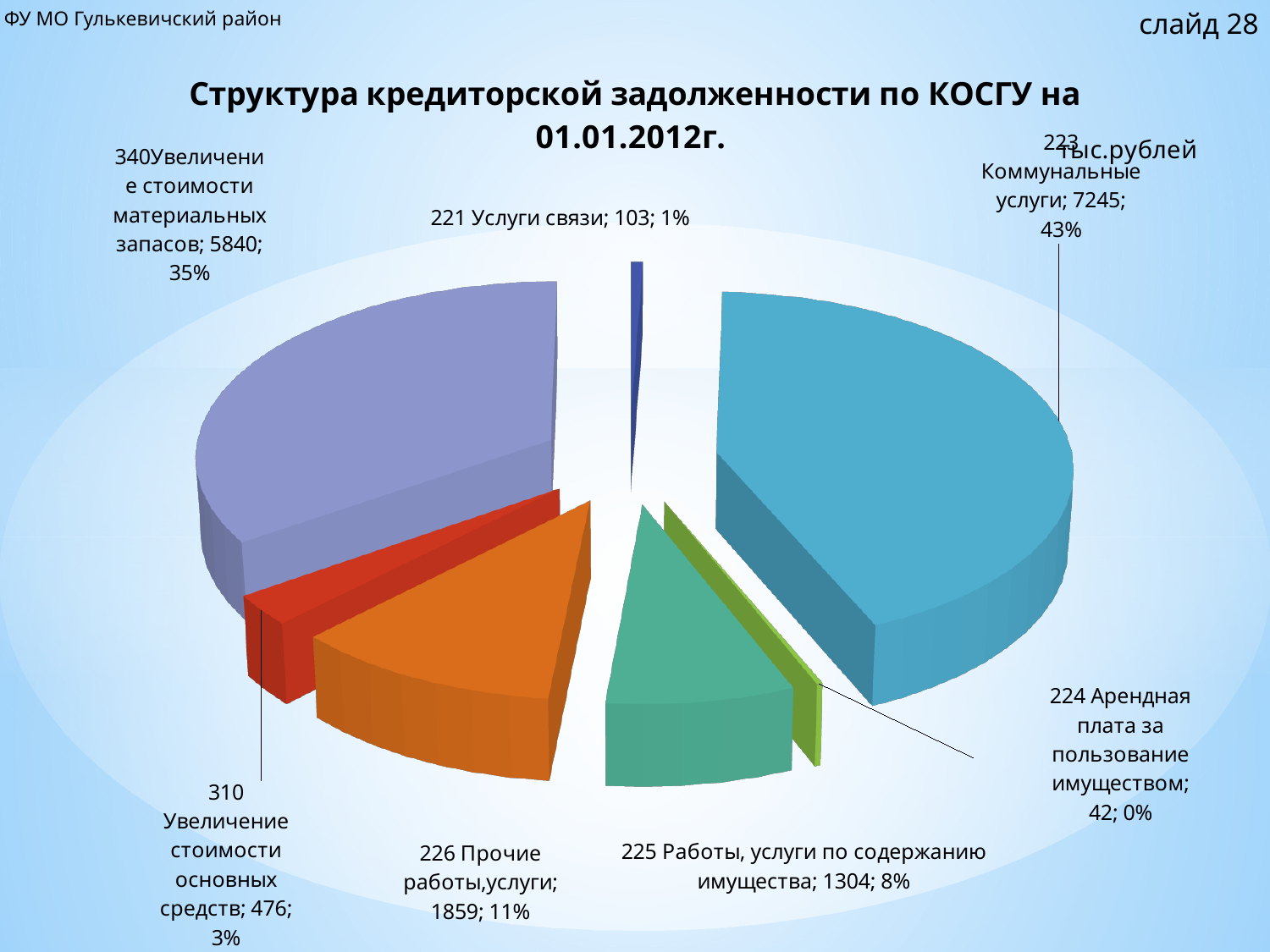
How many slices does the pie chart have? 7 What share of the pie does 225 Работы, услуги по содержанию имущества represent? 8% What is the difference between the values for 223 Коммунальные услуги and 340 Увеличение стоимости материальных запасов? 1405 What is the value for 226 Прочие работы,услуги? 1859 Which category has the largest value? 223 Коммунальные услуги Which is larger: the value for 226 Прочие работы,услуги or the value for 225 Работы, услуги по содержанию имущества? 226 Прочие работы,услуги Which category has the smallest value? 224 Арендная плата за пользование имуществом What is the value for 223 Коммунальные услуги? 7245 What kind of chart is shown on the slide? pie chart What is the title of the chart? Структура кредиторской задолженности по КОСГУ на 01.01.2012г. What is the value for 340 Увеличение стоимости материальных запасов? 5840 What share of the pie does 310 Увеличение стоимости основных средств represent? 3%